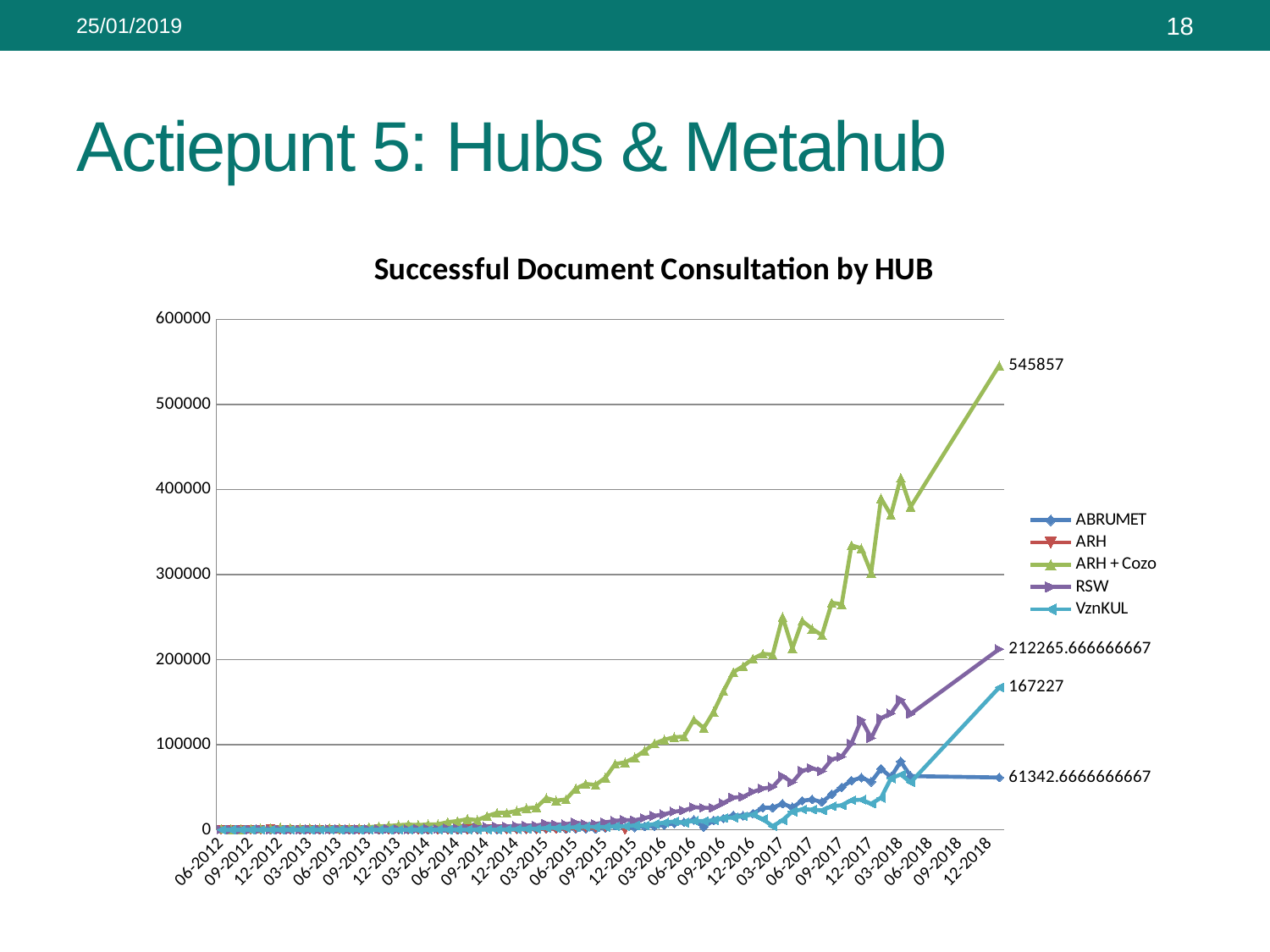
Which series has the larger final value, RSW or VznKUL? RSW What is the difference between the final values of ARH + Cozo (545857) and VznKUL (167227)? 378630 Which series reaches the highest value at the end of the chart? ARH + Cozo What is the title of the chart? Successful Document Consultation by HUB What kind of chart is shown on the slide? line chart What is the final labelled value for the VznKUL series? 167227 What is the final labelled value for the ABRUMET series? 61342.6666666667 How many series does the chart legend list? 5 Is the final value of the ARH + Cozo series greater or less than 500000? greater What is the final labelled value for the RSW series? 212265.666666667 Does the ARH + Cozo series generally rise or fall from 06-2012 to 12-2018? rise What is the final labelled value for the ARH + Cozo series? 545857